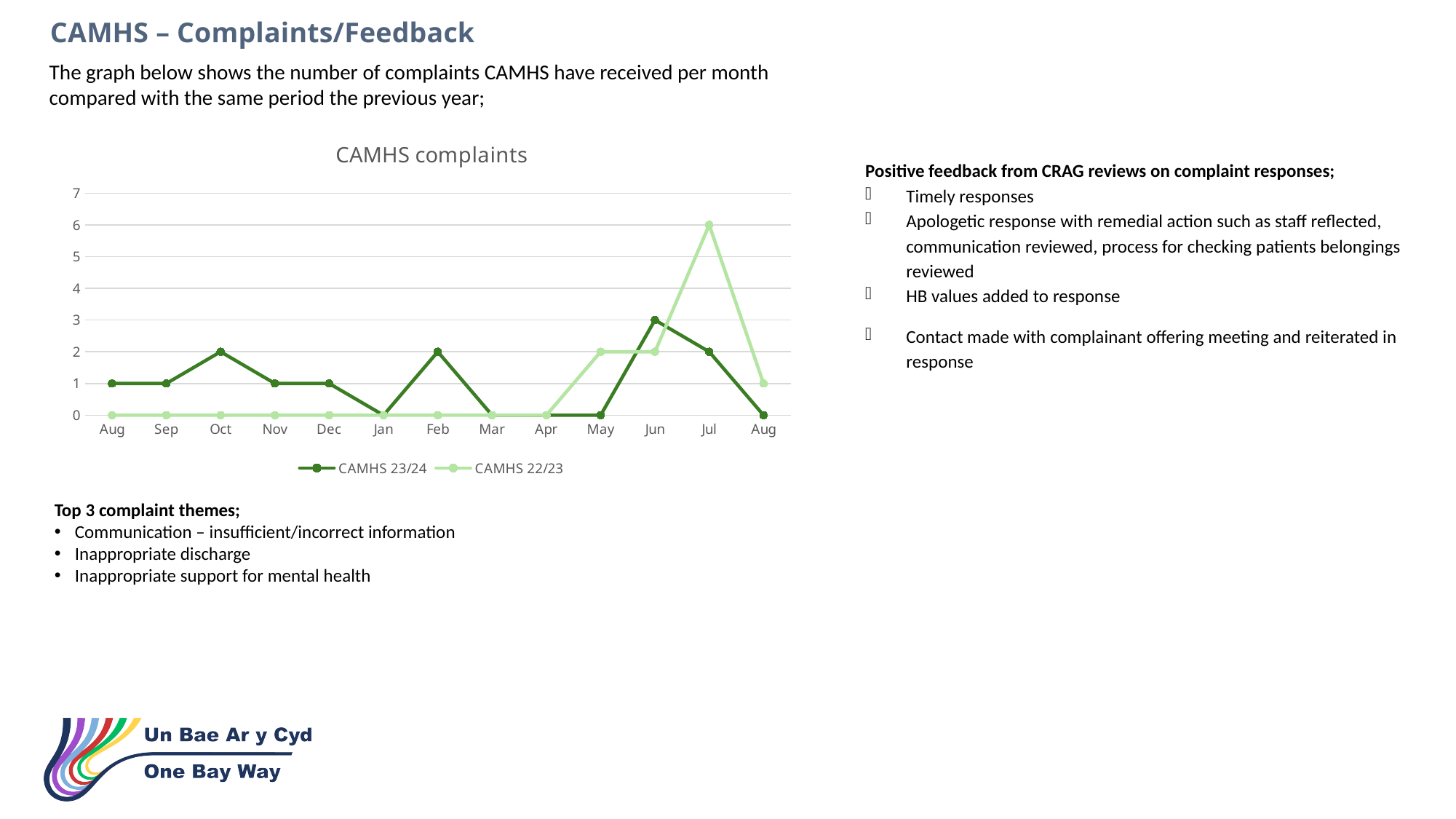
What kind of chart is shown on the slide? Line chart What is the difference between CAMHS 22/23 and CAMHS 23/24 in Jul? 4 What is the value for CAMHS 22/23 in Jul? 6 What is the value for CAMHS 23/24 in Oct? 2 In which month does the CAMHS 23/24 series reach its highest value? Jun Which series has the larger value in Jun, CAMHS 23/24 or CAMHS 22/23? CAMHS 23/24 Is the value for CAMHS 22/23 in Jul greater or less than 5? greater What is the value for CAMHS 23/24 in Jun? 3 How many months are plotted along the x axis of the CAMHS complaints chart? 13 In which month does the CAMHS 22/23 series reach its highest value? Jul How many series does the legend of the CAMHS complaints chart list? 2 What is the title of the chart? CAMHS complaints